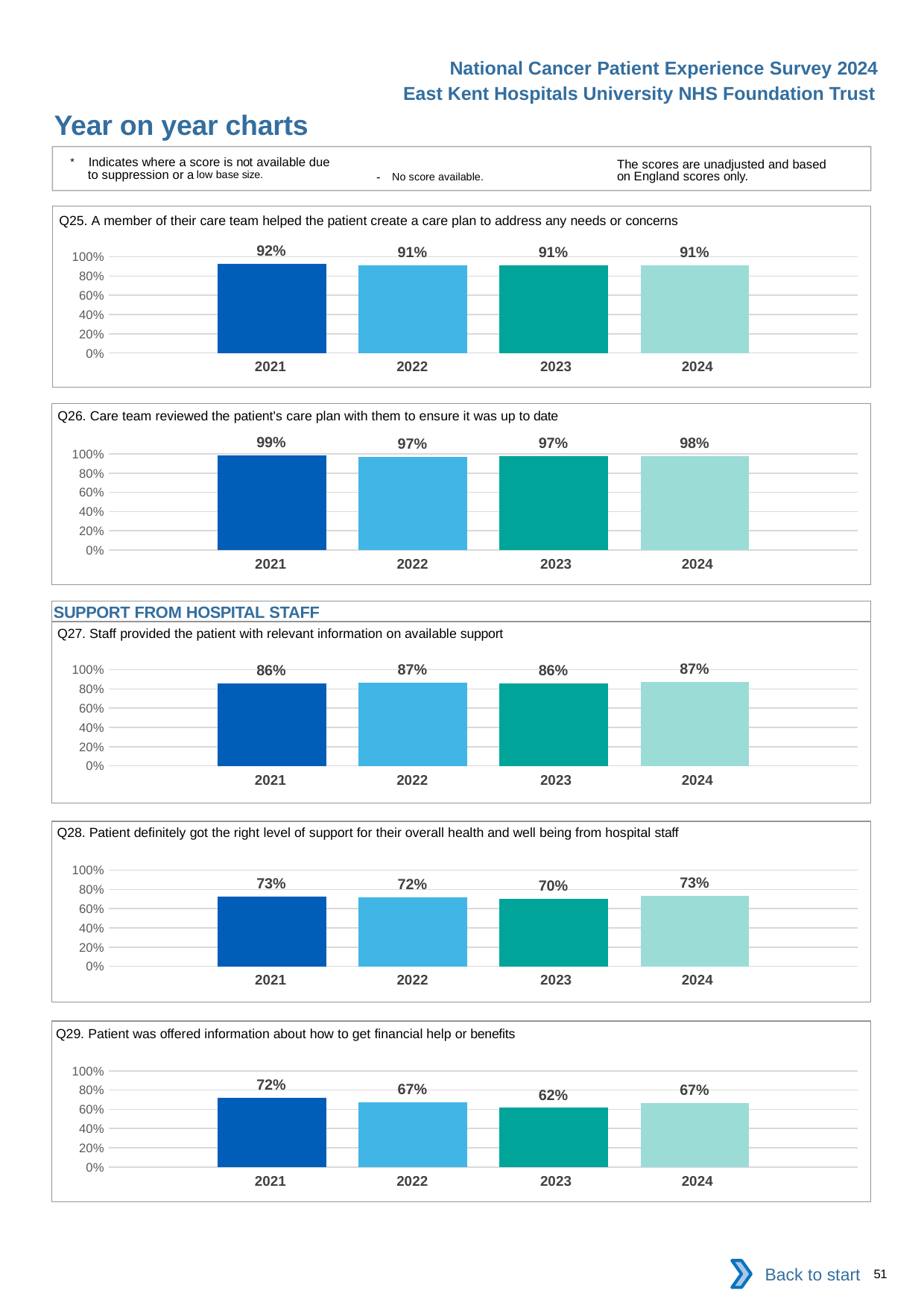
What is the section heading shown above the Q27 chart? SUPPORT FROM HOSPITAL STAFF In the Q26 chart, what is the difference between the 2021 value and the 2022 value? 2% In the Q29 chart, which year has the lowest value? 2023 In the Q27 chart, what is the value for 2024? 87% In the Q25 chart, what is the value for 2021? 92% In the Q29 chart, what is the difference between the 2021 value and the 2023 value? 10% In the Q28 chart, which is larger, the value for 2021 or the value for 2023? 2021 What kind of chart is the Q26 chart? bar chart In the Q29 chart, does the value rise or fall from 2021 to 2023? fall In the Q28 chart, is the value for 2023 greater or less than 80%? less In the Q26 chart, which year has the highest value? 2021 How many years are shown on the x axis of the Q27 chart? 4